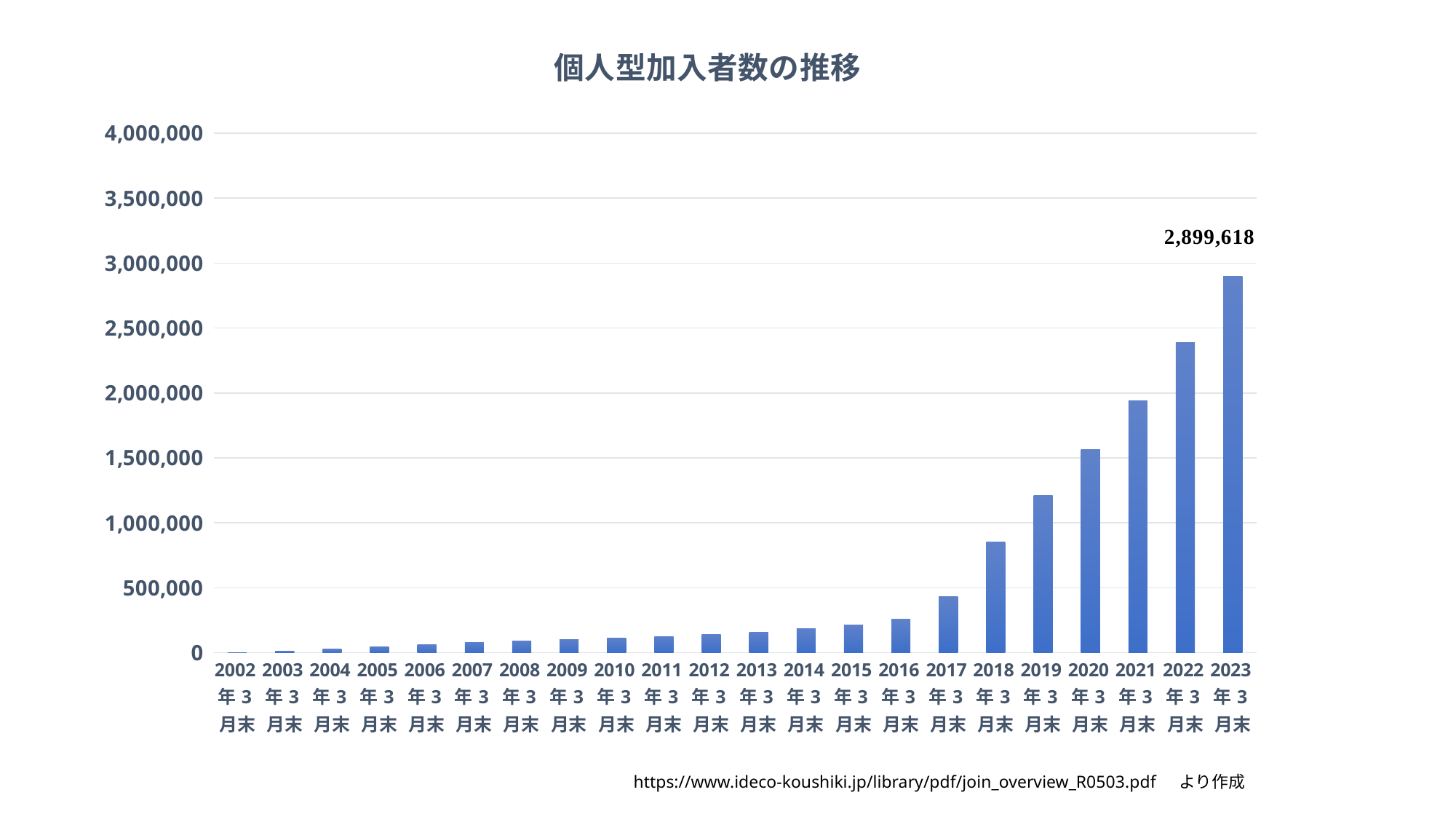
Is the value for 2017年3月末 greater or less than 500,000? less What is the value for 2023年3月末? 2,899,618 Which year-end has the highest number of 個人型加入者? 2023年3月末 Is the value for 2019年3月末 greater or less than 1,000,000? greater Is the value for 2018年3月末 greater or less than 1,000,000? less How many year-end categories are shown on the x axis? 22 Which is larger, the value for 2022年3月末 or the value for 2021年3月末? 2022年3月末 What is the title of the chart? 個人型加入者数の推移 Do the values rise or fall from 2002年3月末 to 2023年3月末? Rise What kind of chart is shown on the slide? Bar chart Which year-end has the lowest number of 個人型加入者? 2002年3月末